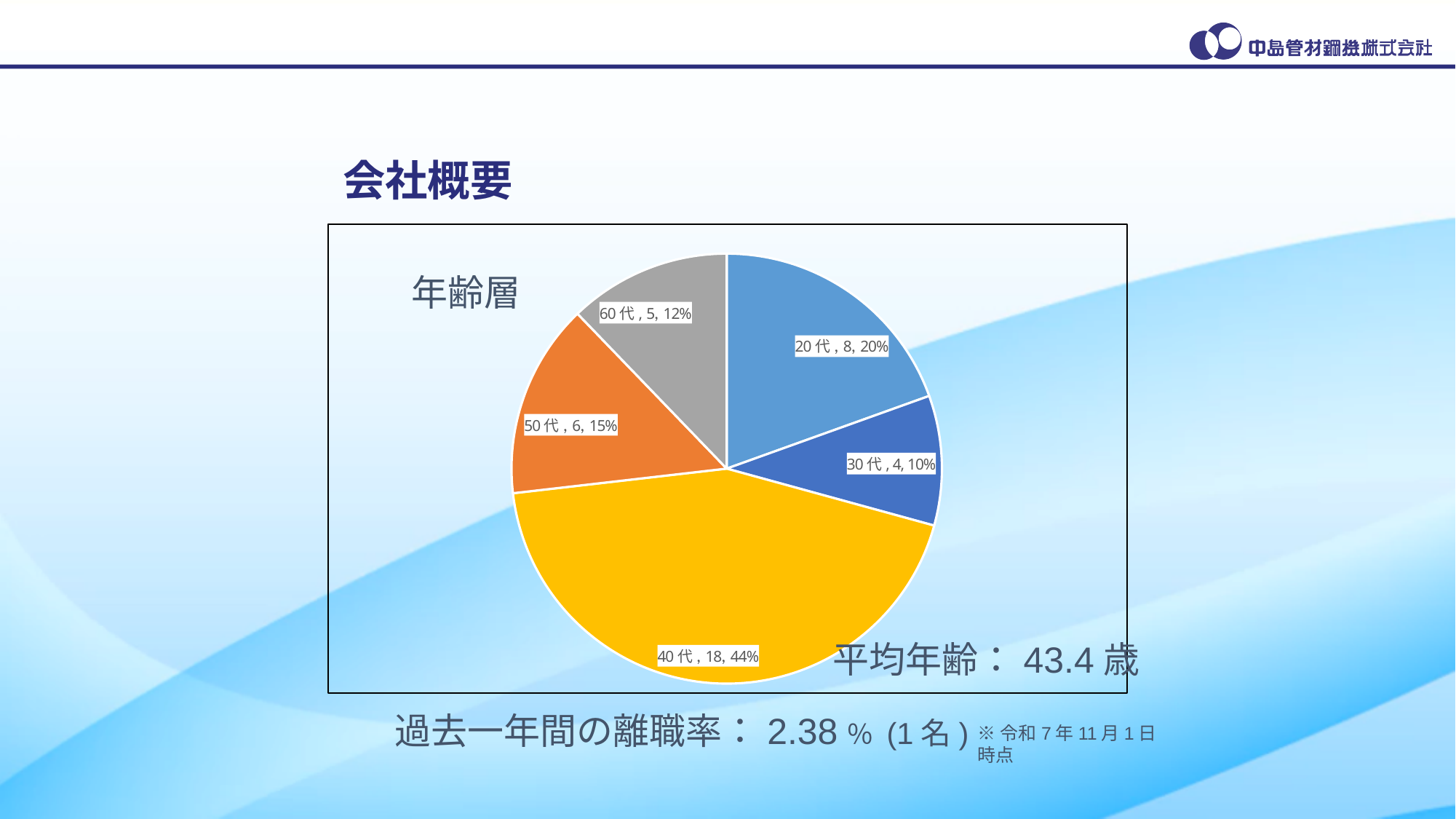
Which age group has the largest slice? 40代 How many people are in the 30代 age group? 4 What is the difference in number of people between the 40代 and 20代 groups? 10 How many slices does the pie chart have? 5 Which group has more people, 50代 or 60代? 50代 What percentage of the pie does the 60代 slice represent? 12% What is the title of the chart? 年齢層 What type of chart is shown on the slide? pie chart Which age group has the smallest slice? 30代 How many people are in the 40代 age group? 18 What is the total number of people across all slices of the pie? 41 What percentage of the pie does the 20代 slice represent? 20%